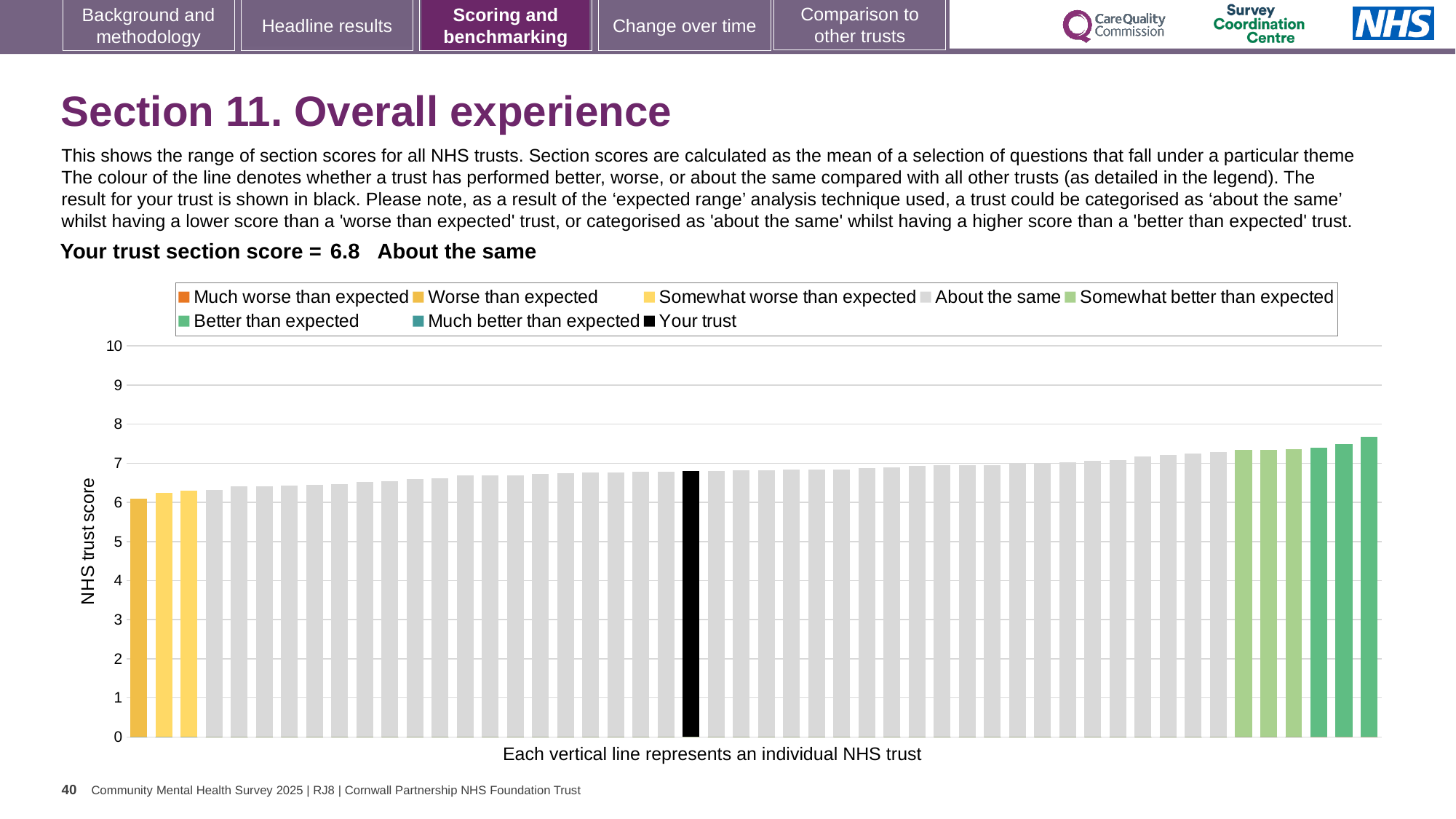
What is the section score for your trust shown on the slide? 6.8 Do the bar values rise or fall from left to right along the x axis? rise What is the label on the vertical axis of the chart? NHS trust score Is the value of the leftmost bar greater or less than 7? less How many entries does the chart legend list? 8 Is the value of the rightmost bar greater or less than 7? greater Is the value of the black 'Your trust' bar greater or less than 7? less Which bar is taller, the leftmost bar or the rightmost bar? rightmost What kind of chart is shown on the slide? bar chart Which category is your trust placed in according to the text above the chart? About the same